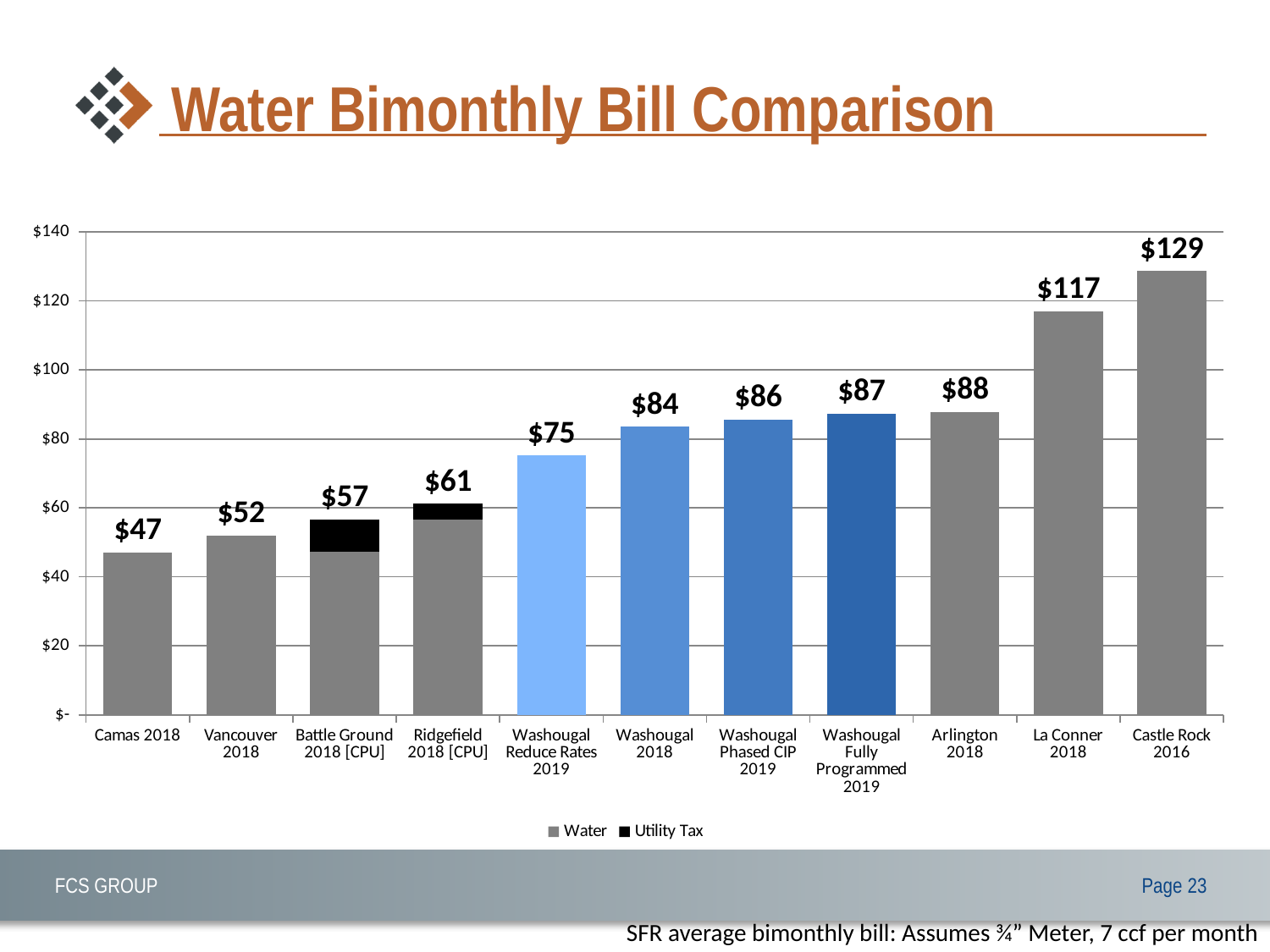
How many series does the legend list? 2 What is the difference between the total bill for Castle Rock 2016 and Camas 2018? $82 Is the total bill for Washougal Fully Programmed 2019 greater or less than $100? less Which category has the highest total bimonthly bill? Castle Rock 2016 What is the difference between the total bill for Washougal 2018 and Washougal Reduce Rates 2019? $9 What is the total bimonthly bill shown for Camas 2018? $47 What is the total bimonthly bill shown for La Conner 2018? $117 Which is larger, the total bill for Arlington 2018 or Ridgefield 2018 [CPU]? Arlington 2018 Which category has the lowest total bimonthly bill? Camas 2018 What is the total bimonthly bill shown for Washougal Reduce Rates 2019? $75 How many categories are shown on the x axis? 11 What kind of chart is shown on the slide? Stacked bar chart